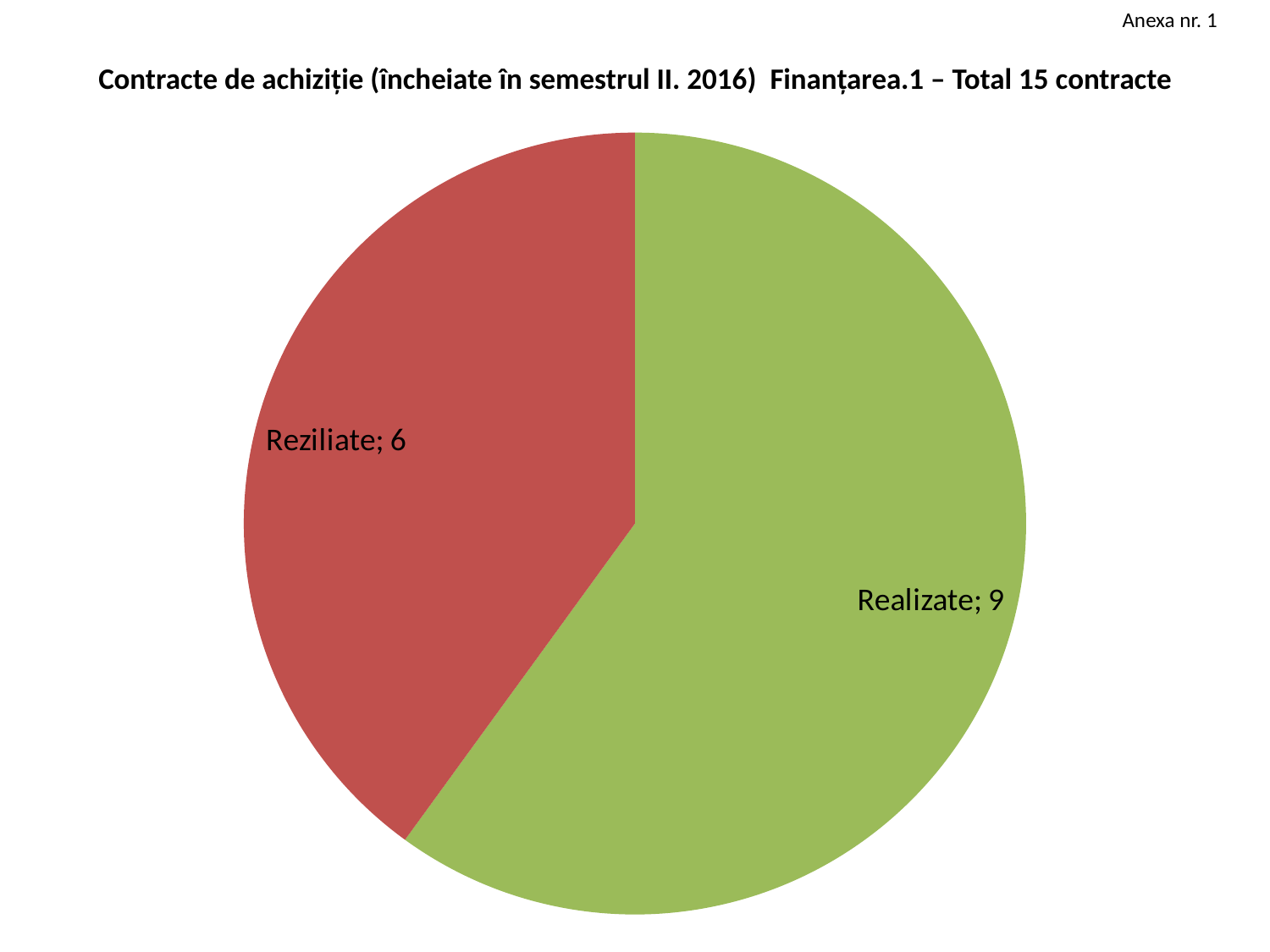
What share of the pie does the Reziliate slice represent? 40% Which slice is the largest? Realizate How many slices does the pie chart have? 2 What kind of chart is shown on the slide? pie chart What is the total of the two slices? 15 How many contracts are labelled Reziliate? 6 What colour is the Reziliate slice? red Which slice is the smallest? Reziliate How many contracts are labelled Realizate? 9 What is the difference between the Realizate and Reziliate values? 3 Which is larger, Realizate or Reziliate? Realizate What share of the pie does the Realizate slice represent? 60%